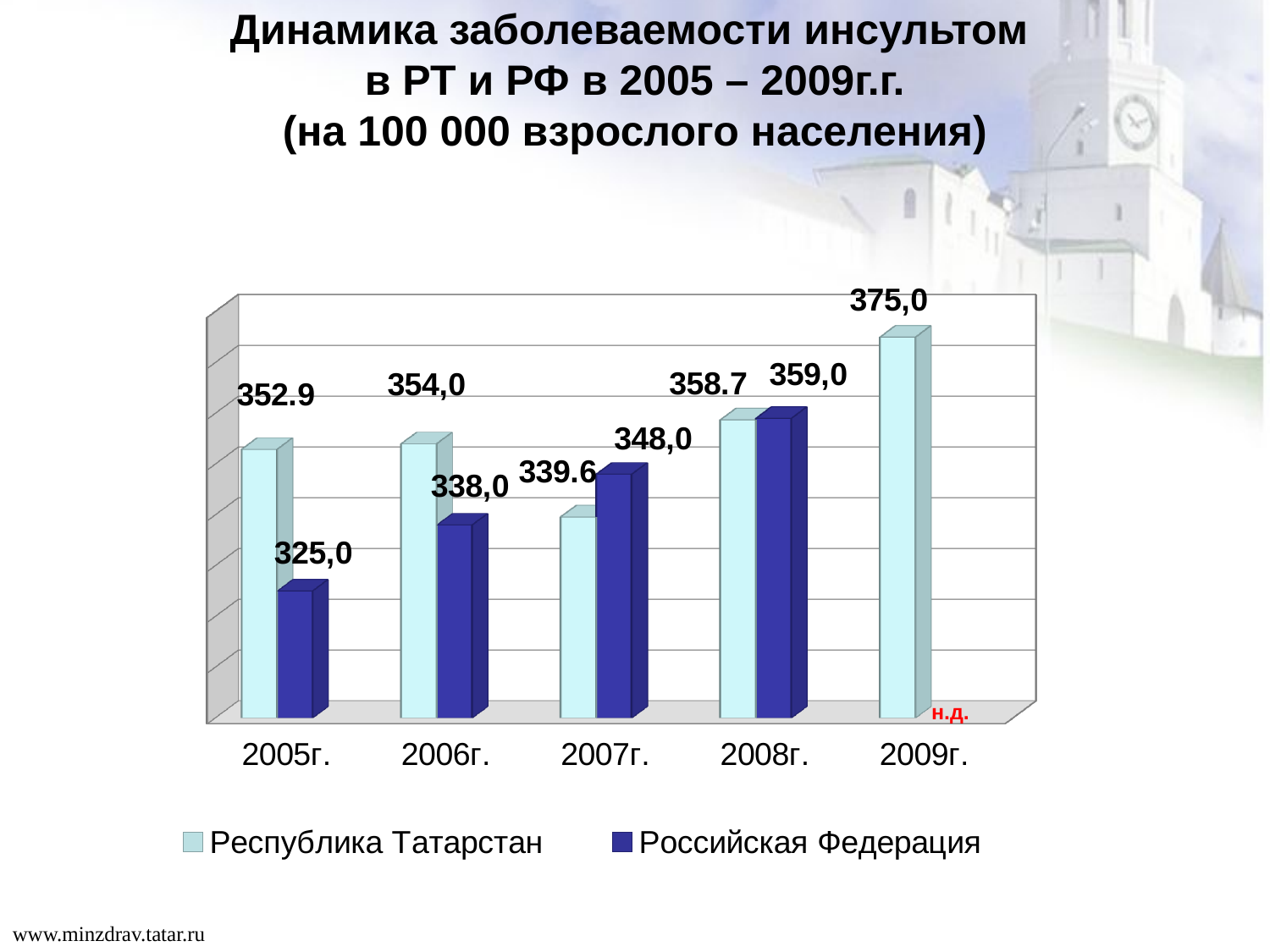
What is the value for Российская Федерация in 2005г.? 325,0 In which year is the value for Республика Татарстан the lowest? 2007г. What kind of chart is shown on the slide? Bar chart What is the value for Республика Татарстан in 2009г.? 375,0 Which is larger in 2007г., the value for Республика Татарстан or for Российская Федерация? Российская Федерация What is the value for Республика Татарстан in 2007г.? 339.6 How many series does the legend list? 2 What is the value for Российская Федерация in 2008г.? 359,0 In which year is the value for Республика Татарстан the highest? 2009г. In which year is the value for Российская Федерация the lowest? 2005г. What is the difference between the Республика Татарстан and Российская Федерация values in 2005г.? 27.9 How many years are shown on the x axis? 5